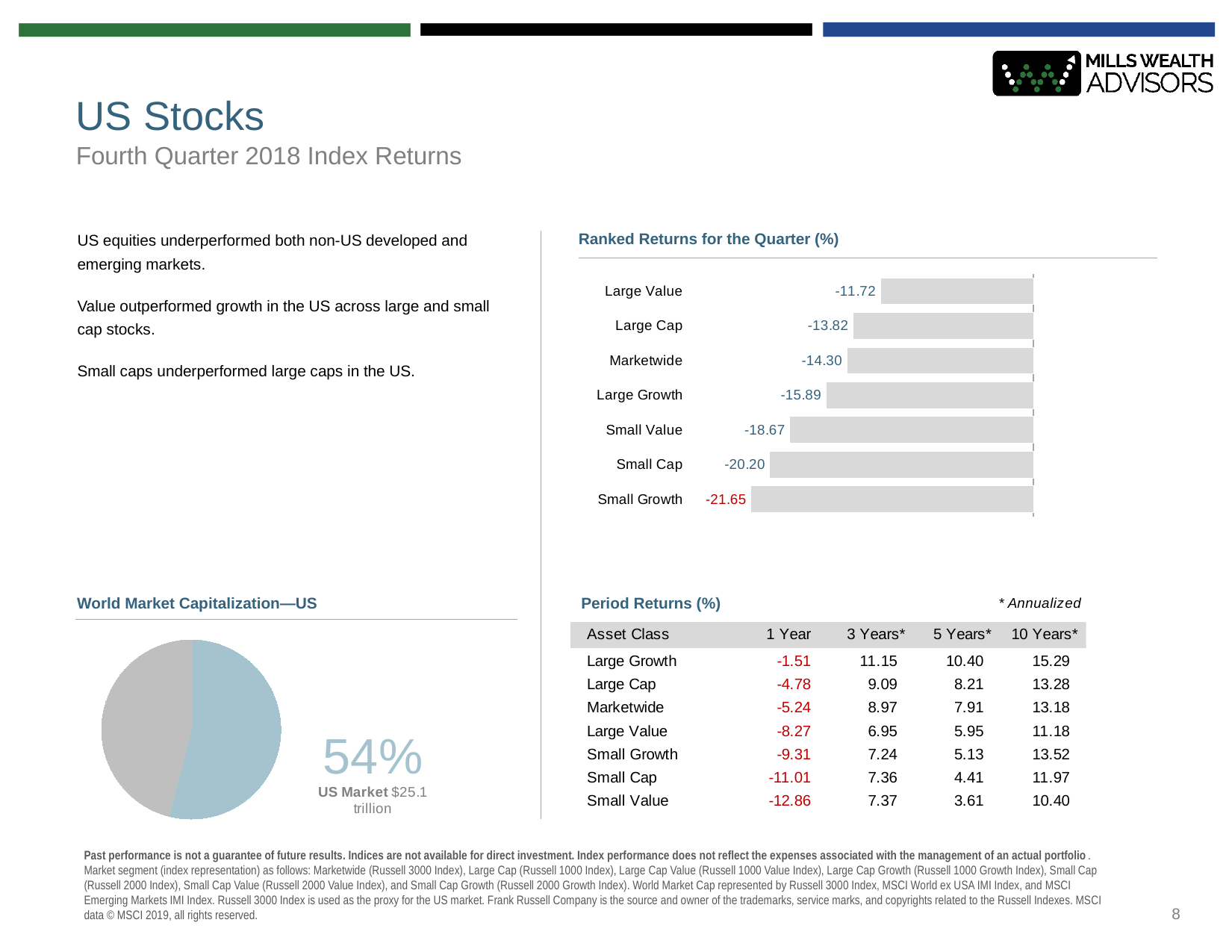
In the Ranked Returns for the Quarter chart, what is the value for Large Value? -11.72 In the Ranked Returns for the Quarter chart, what is the value for Small Cap? -20.20 In the Ranked Returns for the Quarter chart, what is the difference between the Large Cap and Small Cap values? 6.38 How many categories are shown in the Ranked Returns for the Quarter chart? 7 In the World Market Capitalization—US chart, what share of the pie does the US Market represent? 54% What kind of chart is the World Market Capitalization—US chart? Pie chart In the Ranked Returns for the Quarter chart, which is larger, the value for Large Growth or the value for Small Value? Large Growth In the Ranked Returns for the Quarter chart, which category has the highest return? Large Value In the Ranked Returns for the Quarter chart, what is the value for Marketwide? -14.30 What kind of chart is the Ranked Returns for the Quarter chart? Bar chart In the Ranked Returns for the Quarter chart, which category has the lowest return? Small Growth In the World Market Capitalization—US chart, what dollar value is given for the US Market? $25.1 trillion